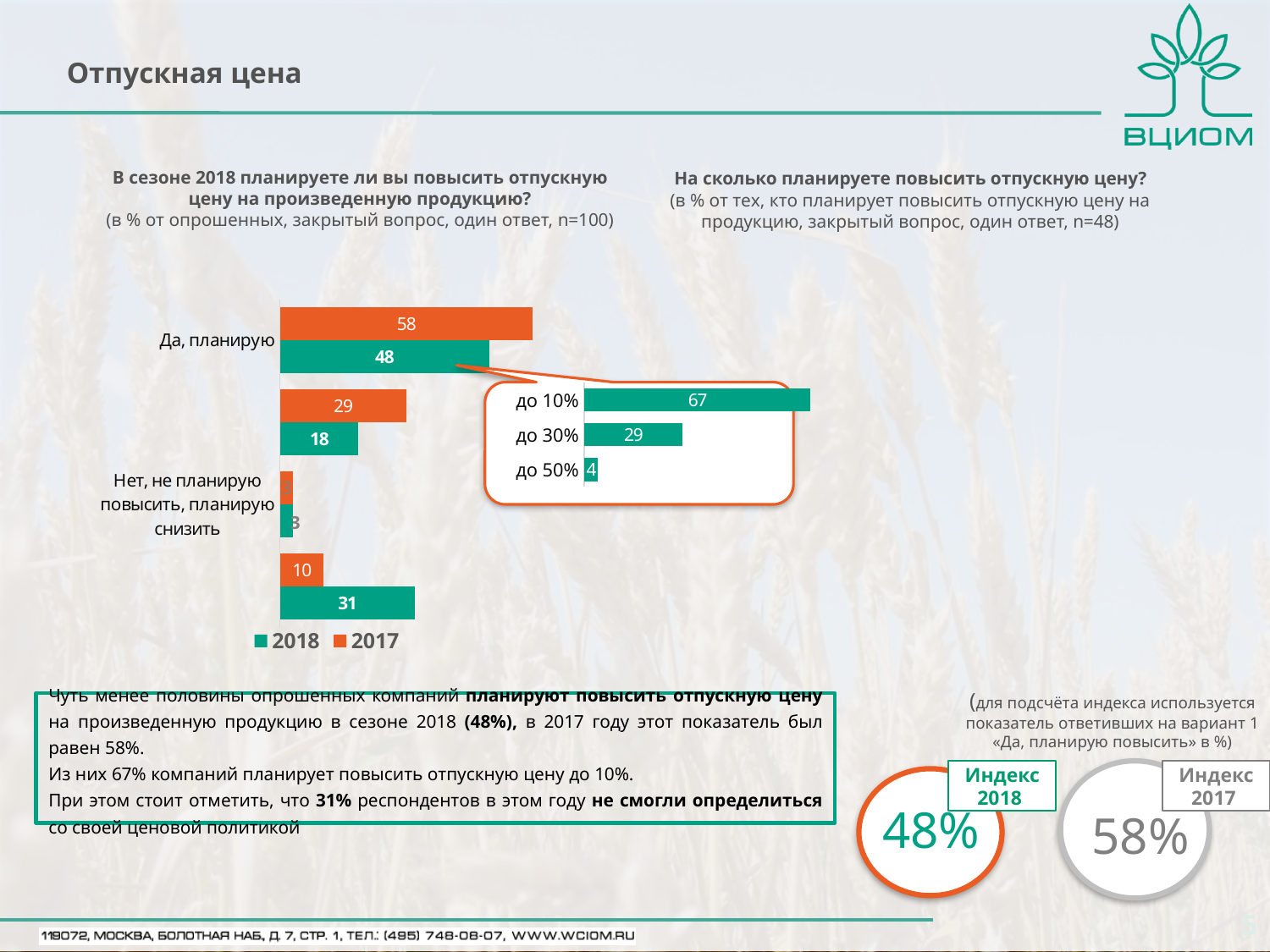
In the callout chart on the right, which category has the highest value? до 10% In the callout chart on the right, what is the value for "до 30%"? 29 In the left bar chart, what is the 2018 value for "Да, планирую"? 48 How many categories are shown in the callout chart on the right? 3 In the left bar chart, what is the 2017 value for "Да, планирую"? 58 In the left bar chart, which year has the larger value for "Да, планирую", 2018 or 2017? 2017 In the callout chart on the right, which category has the lowest value? до 50% What kind of chart is the left chart on the slide? Bar chart In the callout chart on the right, what is the value for "до 50%"? 4 How many series does the legend of the left bar chart list? 2 In the left bar chart, what is the difference between the 2017 and 2018 values for "Да, планирую"? 10 In the callout chart on the right, what is the value for "до 10%"? 67